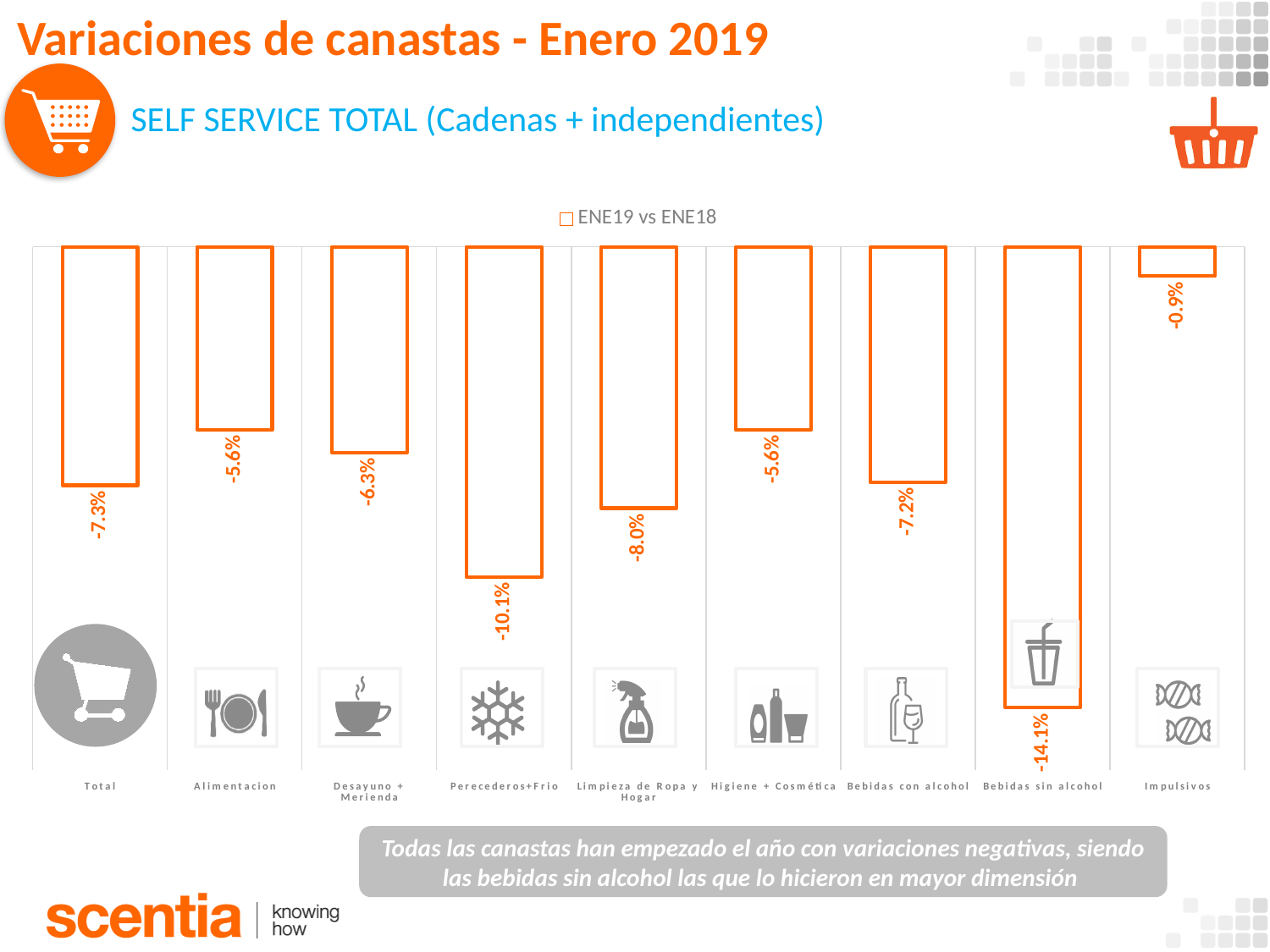
What is the legend entry of the chart? ENE19 vs ENE18 Which category has the highest value (smallest negative variation)? Impulsivos Which category has the lowest value (largest negative variation)? Bebidas sin alcohol Which has a larger negative variation, Limpieza de Ropa y Hogar or Desayuno + Merienda? Limpieza de Ropa y Hogar What is the difference between the values for Bebidas sin alcohol and Bebidas con alcohol? 6.9 percentage points What is the value for Bebidas sin alcohol? -14.1% How many categories are shown in the chart? 9 What is the value for Total? -7.3% What is the value for Impulsivos? -0.9% How many series does the legend list? 1 What kind of chart is shown on the slide? Bar chart What is the value for Perecederos+Frio? -10.1%